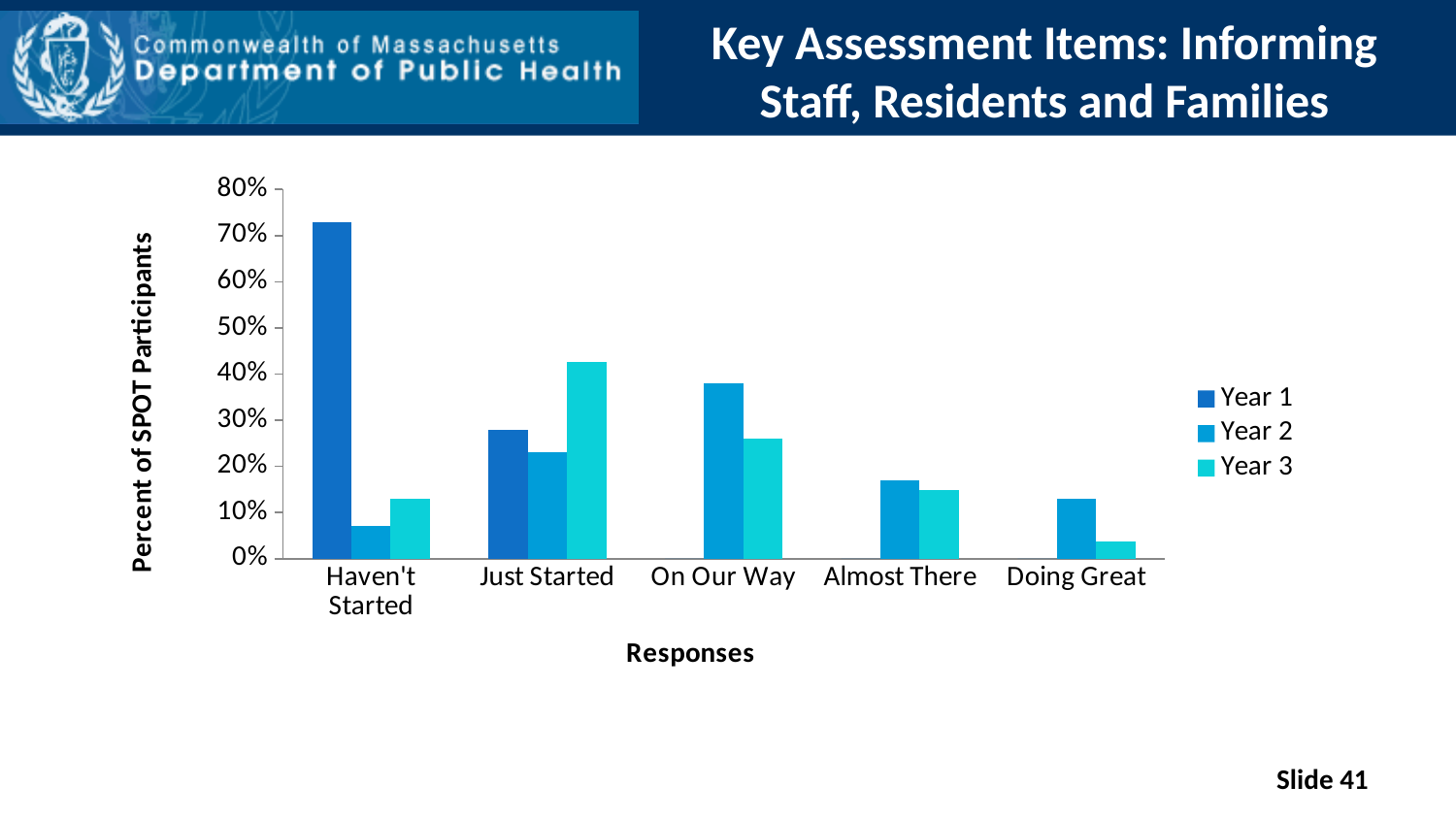
For Year 1, which response category has the highest value? Haven't Started For Year 3, which response category has the lowest value? Doing Great For On Our Way, which is larger: the Year 2 value or the Year 3 value? Year 2 For Year 2, which response category has the highest value? On Our Way Is the Year 1 value for Haven't Started greater or less than 70%? greater How many series does the legend list? 3 Is the Year 3 value for Just Started greater or less than 40%? greater Is the Year 2 value for Haven't Started greater or less than 10%? less For Just Started, which is larger: the Year 1 value or the Year 3 value? Year 3 How many response categories are shown on the x axis? 5 What kind of chart is shown on the slide? bar chart What is the title of the vertical axis? Percent of SPOT Participants